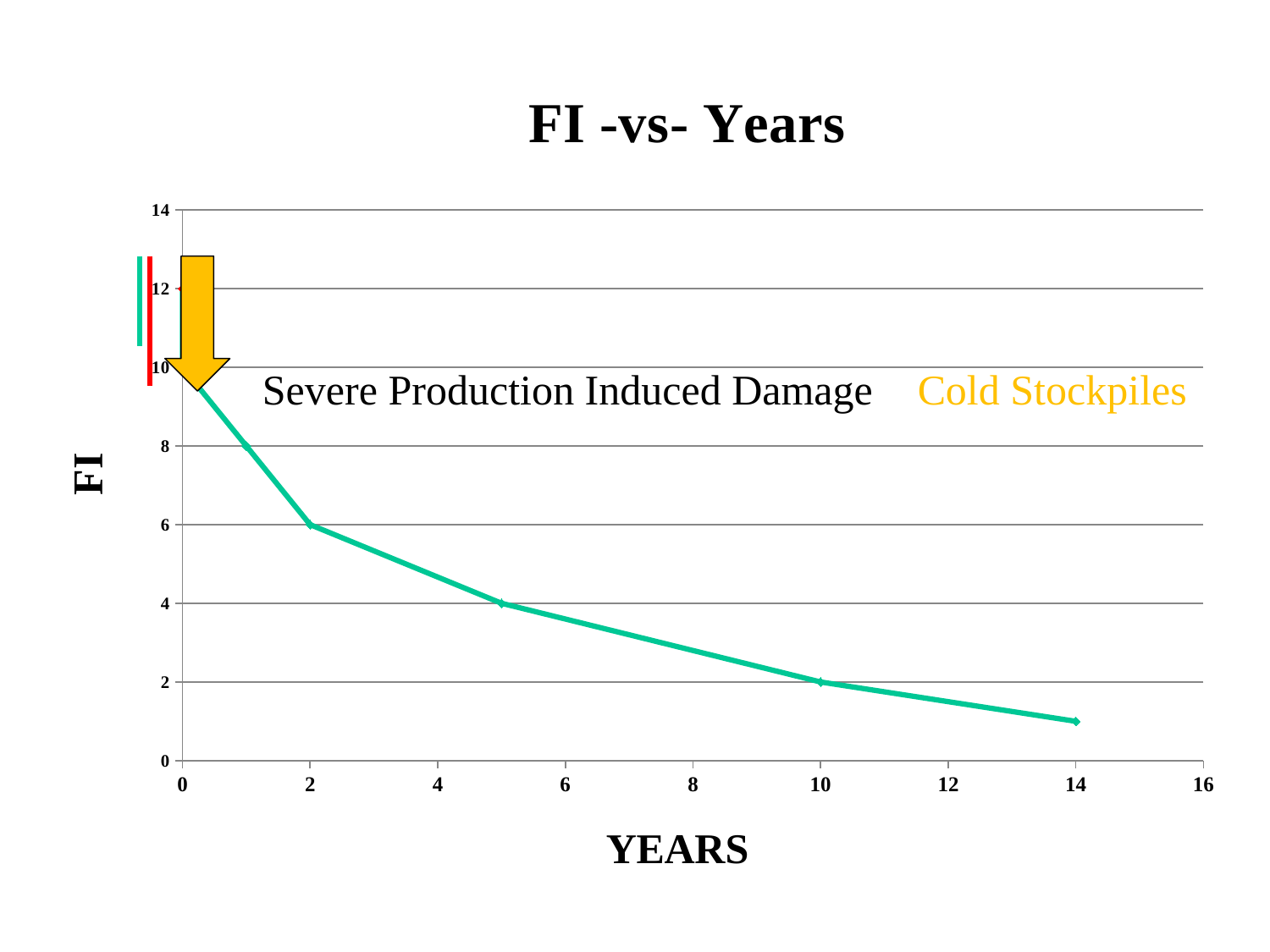
Is the FI value at 14 years greater or less than 2? less Does FI rise or fall as the years increase? fall Is the FI value at 1 year greater or less than 6? greater What is the FI value at 10 years? 2 What is the difference between the FI value at 2 years and the FI value at 10 years? 4 Which has the larger FI value, 2 years or 10 years? 2 years Is the FI value at 5 years greater or less than 6? less What is the label of the x axis? YEARS What is the FI value at 2 years? 6 What is the title of the chart? FI -vs- Years What kind of chart is shown on the slide? line chart